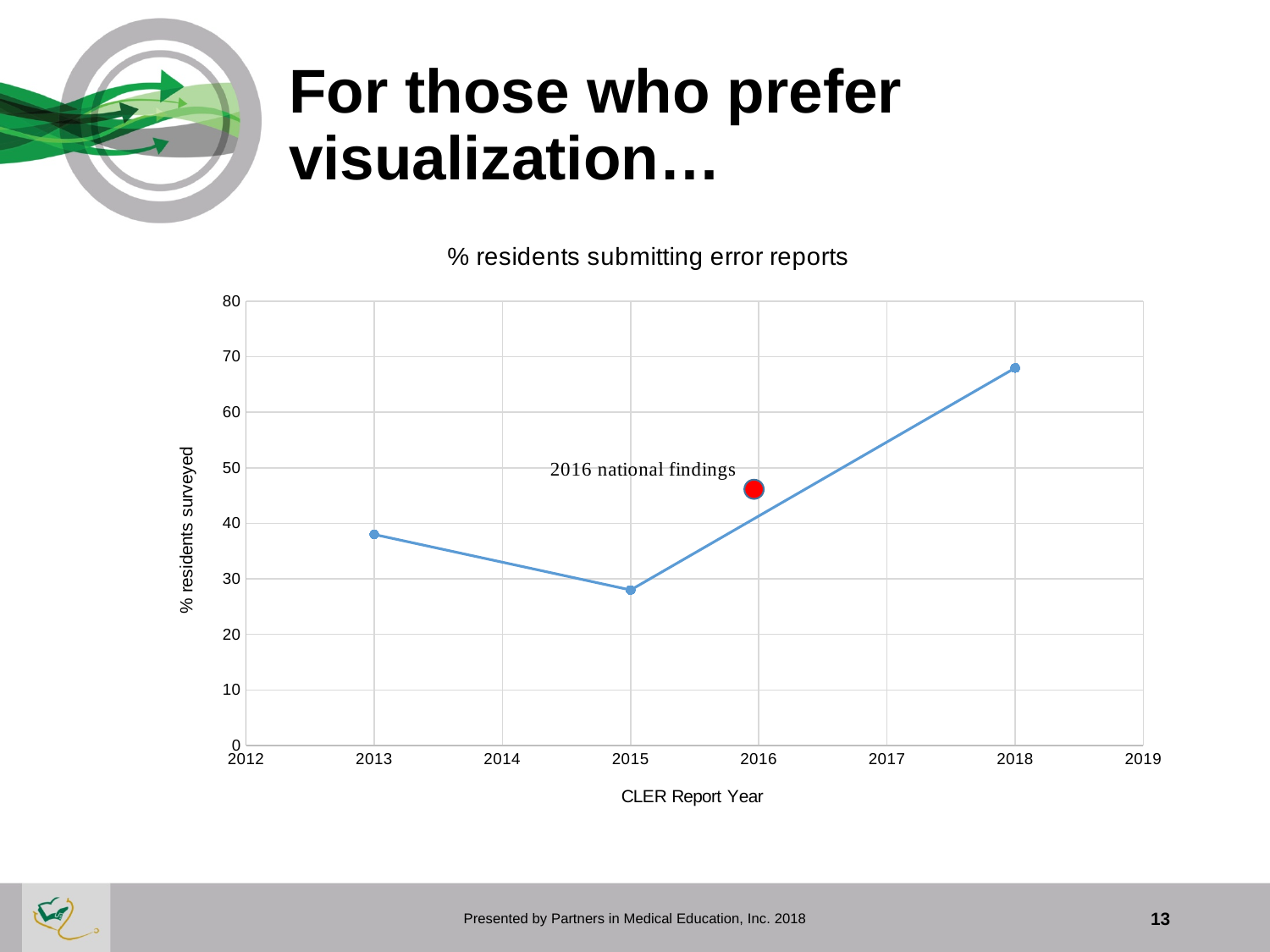
Is the value for 2018 greater or less than 70? less Does the blue line rise or fall between 2015 and 2018? rise What is the label of the x axis? CLER Report Year Is the value for 2018 greater or less than 60? greater Is the value of the red marker labelled '2016 national findings' greater or less than 40? greater Which CLER report year has the lowest % of residents surveyed on the blue line? 2015 What is the title of the chart? % residents submitting error reports Which is larger, the value for 2013 or the value for 2015? 2013 What kind of chart is shown on the slide? line chart Which CLER report year has the highest % of residents surveyed on the blue line? 2018